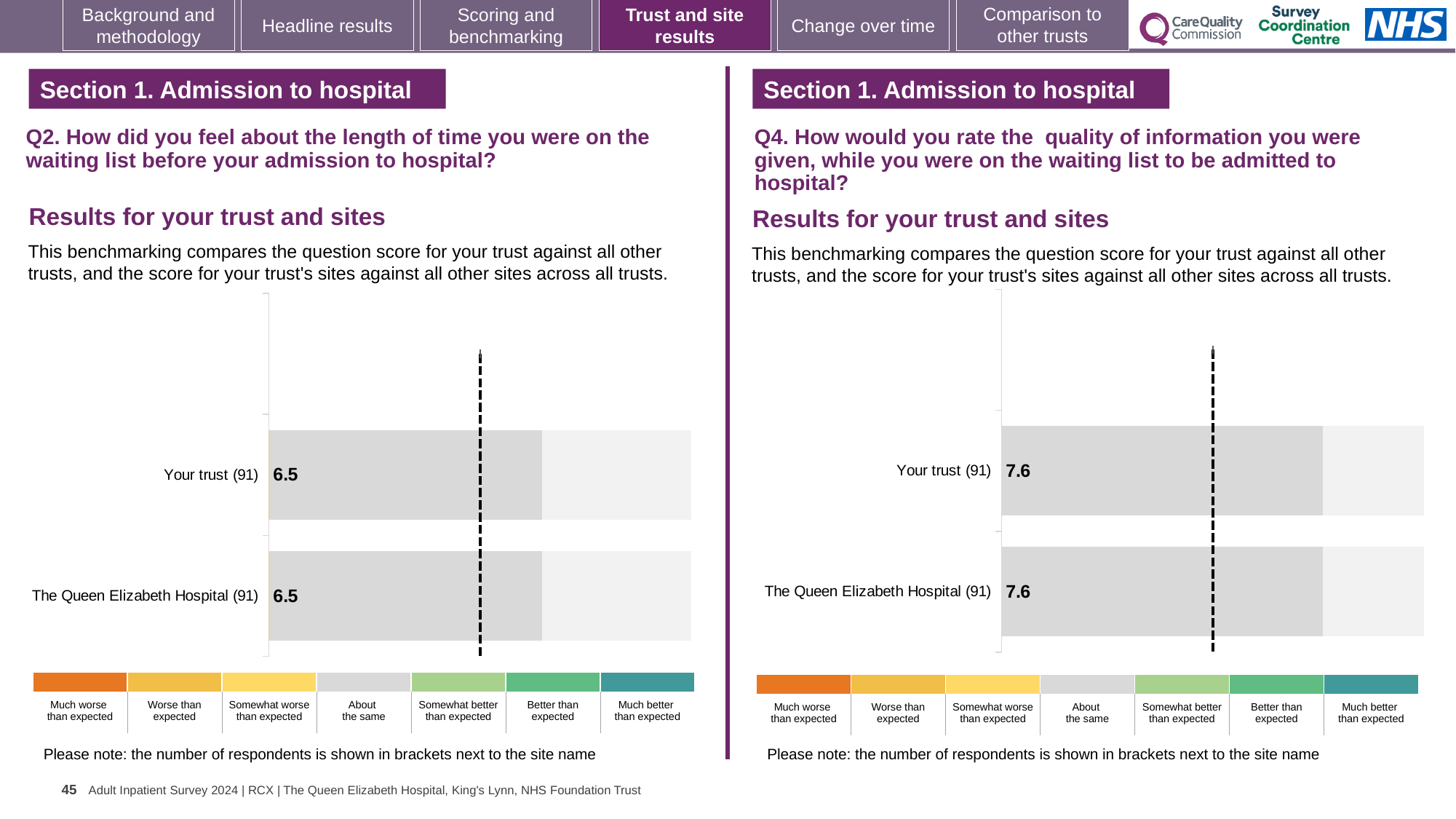
In the Q4 chart on the right, how many respondents are shown in brackets next to Your trust? 91 In the Q2 chart on the left, what is the score for The Queen Elizabeth Hospital (91)? 6.5 In the Q4 chart on the right, what is the score for Your trust (91)? 7.6 How many bars are plotted in the Q2 chart on the left? 2 In the Q2 chart on the left, what is the difference between the score for Your trust and the score for The Queen Elizabeth Hospital? 0.0 How many colour categories does the legend below the Q2 chart on the left list? 7 How many bars are plotted in the Q4 chart on the right? 2 What kind of chart is used in the Q2 chart on the left? Bar chart In the Q4 chart on the right, what is the difference between the score for Your trust and the score for The Queen Elizabeth Hospital? 0.0 In the Q2 chart on the left, what is the score for Your trust (91)? 6.5 In the Q4 chart on the right, what is the score for The Queen Elizabeth Hospital (91)? 7.6